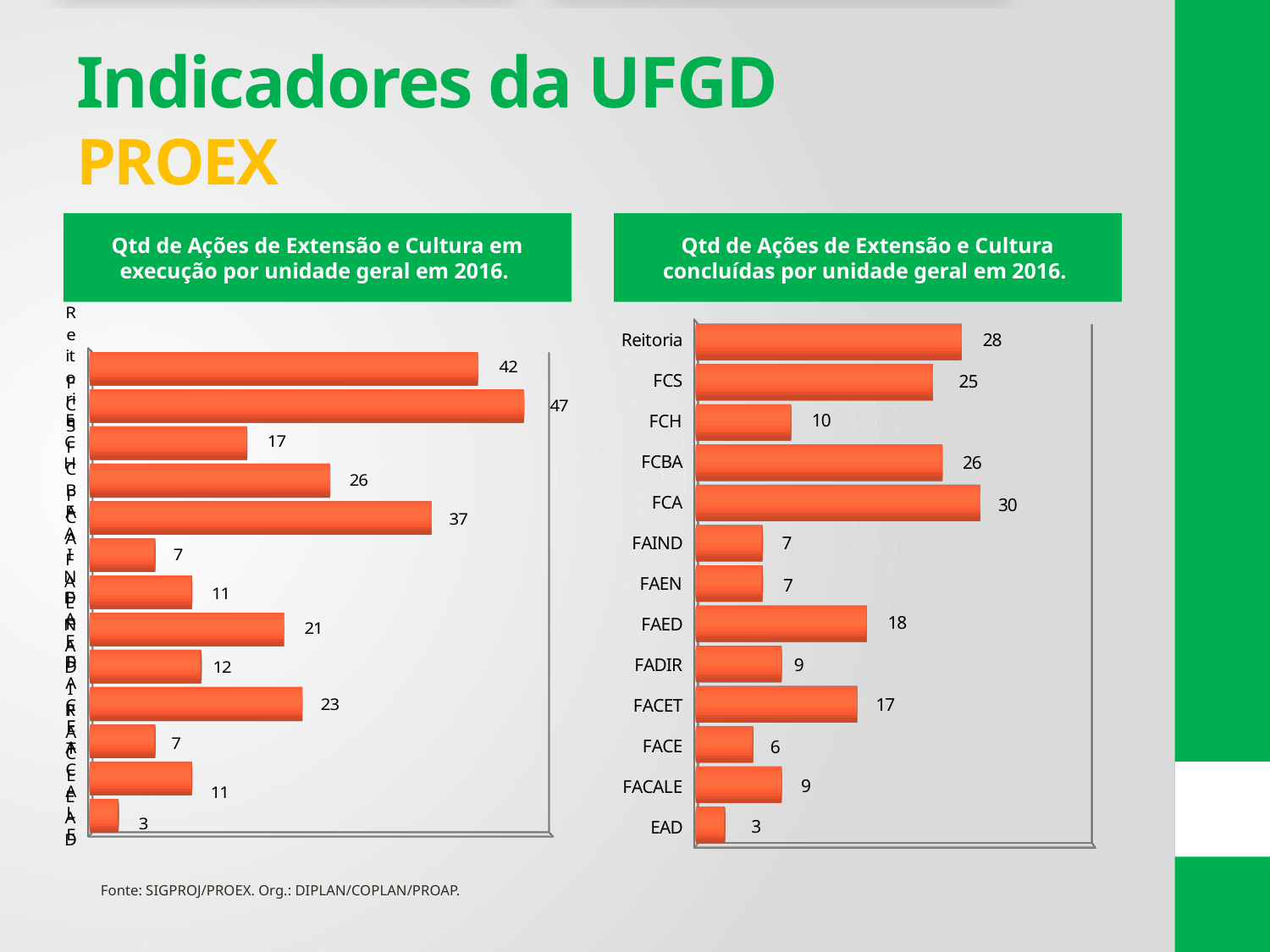
In the chart 'Qtd de Ações de Extensão e Cultura concluídas por unidade geral em 2016', which unit has the lowest value? EAD In the chart 'Qtd de Ações de Extensão e Cultura em execução por unidade geral em 2016', what is the lowest value shown on any bar? 3 In the chart 'Qtd de Ações de Extensão e Cultura concluídas por unidade geral em 2016', what is the value for FCA? 30 How many units are shown in the chart 'Qtd de Ações de Extensão e Cultura concluídas por unidade geral em 2016'? 13 In the chart 'Qtd de Ações de Extensão e Cultura concluídas por unidade geral em 2016', what is the difference between the values for FCBA and FCH? 16 In the chart 'Qtd de Ações de Extensão e Cultura concluídas por unidade geral em 2016', what is the value for FAED? 18 What kind of chart is 'Qtd de Ações de Extensão e Cultura concluídas por unidade geral em 2016'? Bar chart In the chart 'Qtd de Ações de Extensão e Cultura concluídas por unidade geral em 2016', what is the value for Reitoria? 28 How many bars are shown in the chart 'Qtd de Ações de Extensão e Cultura em execução por unidade geral em 2016'? 13 In the chart 'Qtd de Ações de Extensão e Cultura em execução por unidade geral em 2016', what is the highest value shown on any bar? 47 In the chart 'Qtd de Ações de Extensão e Cultura concluídas por unidade geral em 2016', which is larger, the value for FCS or the value for FACET? FCS In the chart 'Qtd de Ações de Extensão e Cultura concluídas por unidade geral em 2016', which unit has the highest value? FCA